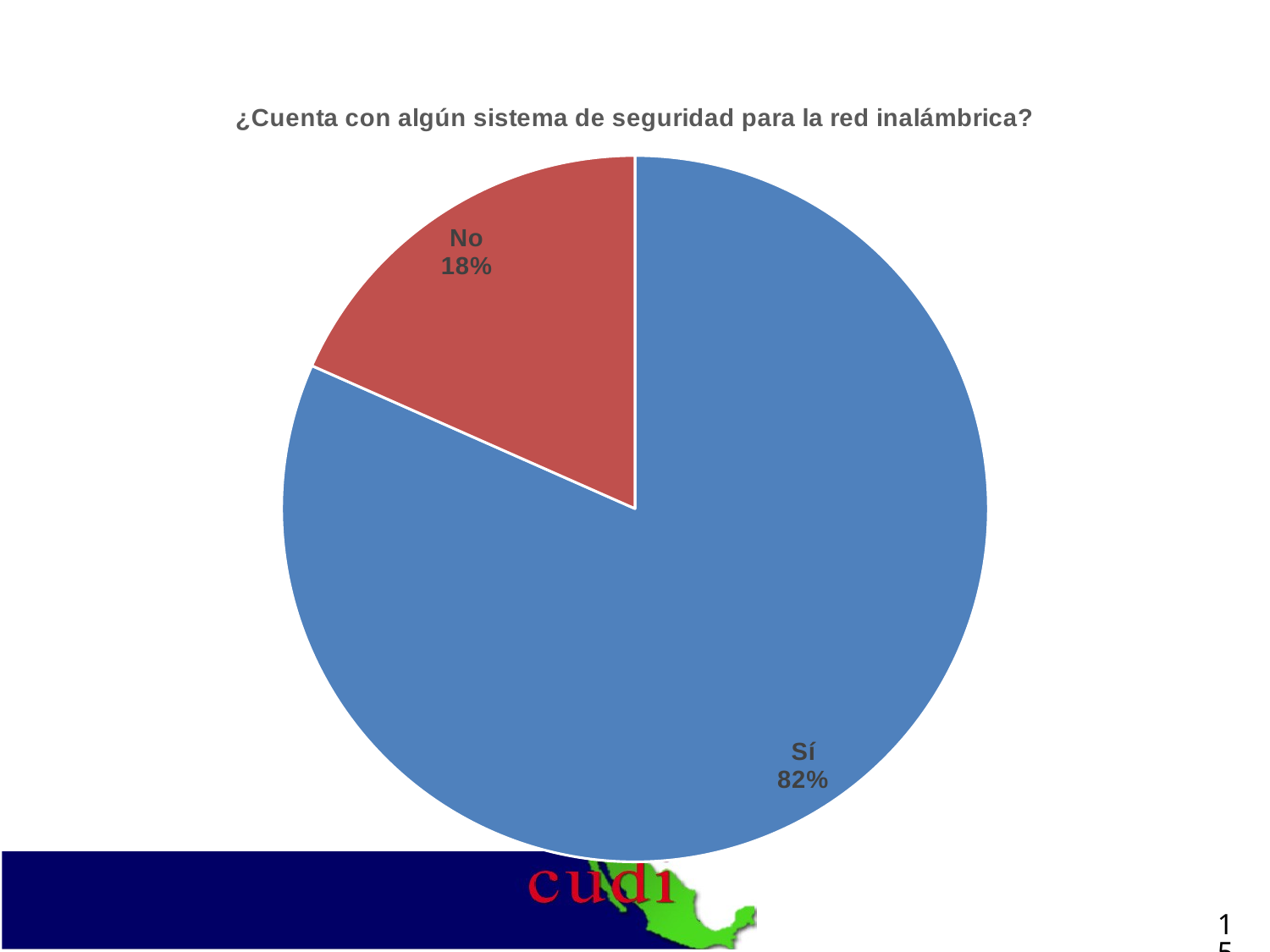
What is the difference in percentage points between the "Sí" and "No" slices? 64 Which is larger, the "Sí" slice or the "No" slice? Sí Which slice of the pie is the largest? Sí What percentage of the pie is labelled "Sí"? 82% What is the title of the chart? ¿Cuenta con algún sistema de seguridad para la red inalámbrica? What share of the pie does the "No" slice represent? 18% How many slices does the pie chart have? 2 What colour is the "No" slice? red Which slice of the pie is the smallest? No What percentage of the pie is labelled "No"? 18% What type of chart is shown on the slide? pie chart